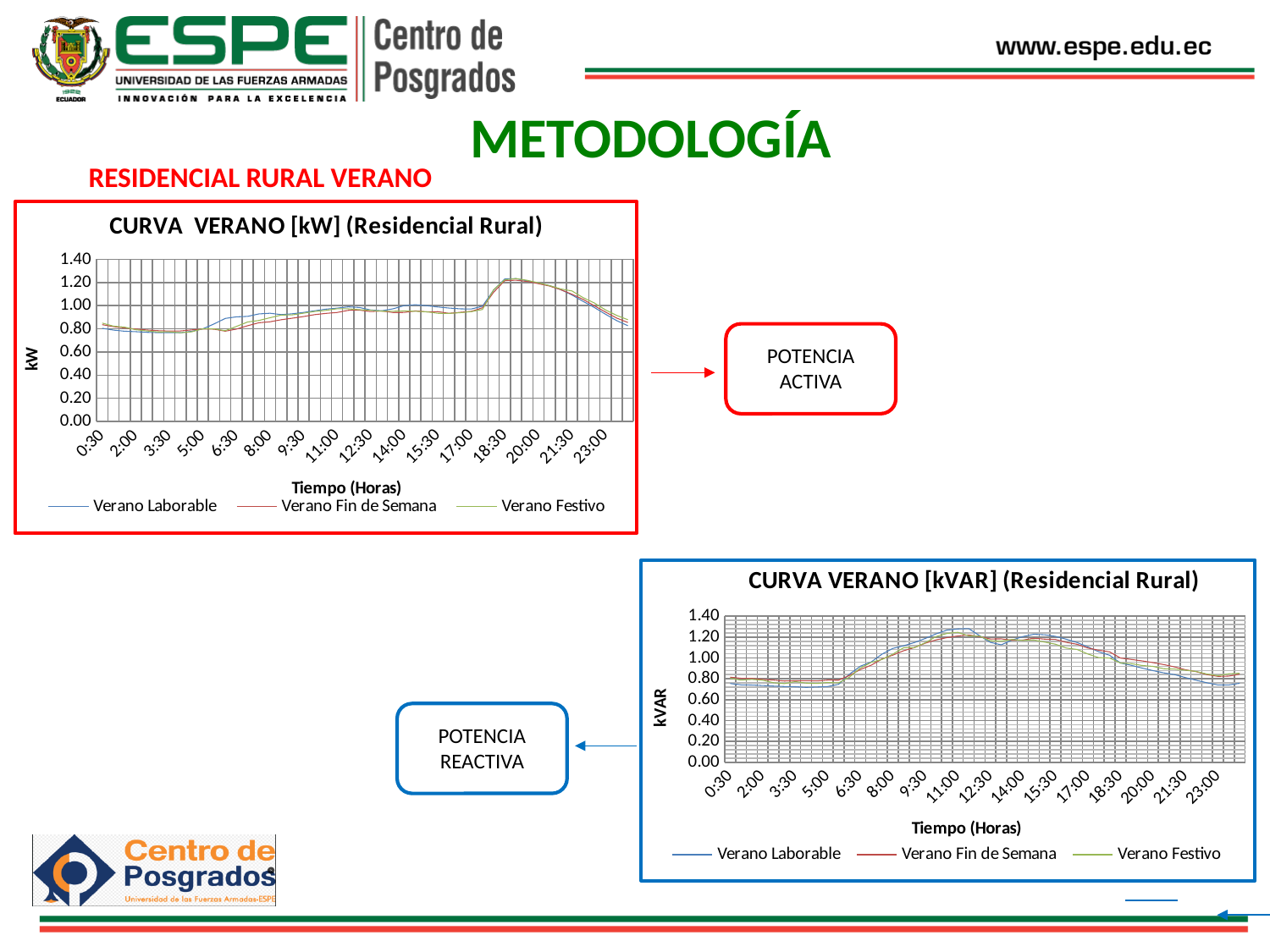
What kind of chart is the 'CURVA VERANO [kW] (Residencial Rural)' chart? line chart How many series does the legend of the 'CURVA VERANO [kW] (Residencial Rural)' chart list? 3 What is the y-axis label of the 'CURVA VERANO [kW] (Residencial Rural)' chart? kW In the 'CURVA VERANO [kVAR] (Residencial Rural)' chart, do the values rise or fall between 5:00 and 11:00? rise How many series does the legend of the 'CURVA VERANO [kVAR] (Residencial Rural)' chart list? 3 What is the x-axis label of the 'CURVA VERANO [kVAR] (Residencial Rural)' chart? Tiempo (Horas) What kind of chart is the 'CURVA VERANO [kVAR] (Residencial Rural)' chart? line chart In the 'CURVA VERANO [kVAR] (Residencial Rural)' chart, is the value for Verano Fin de Semana at 11:00 greater or less than 1.00? greater In the 'CURVA VERANO [kW] (Residencial Rural)' chart, is the value for Verano Laborable at 0:30 greater or less than 1.00? less In the 'CURVA VERANO [kW] (Residencial Rural)' chart, do the values rise or fall between 20:00 and 23:00? fall In the 'CURVA VERANO [kVAR] (Residencial Rural)' chart, is the value for Verano Laborable at 23:00 greater or less than 1.00? less